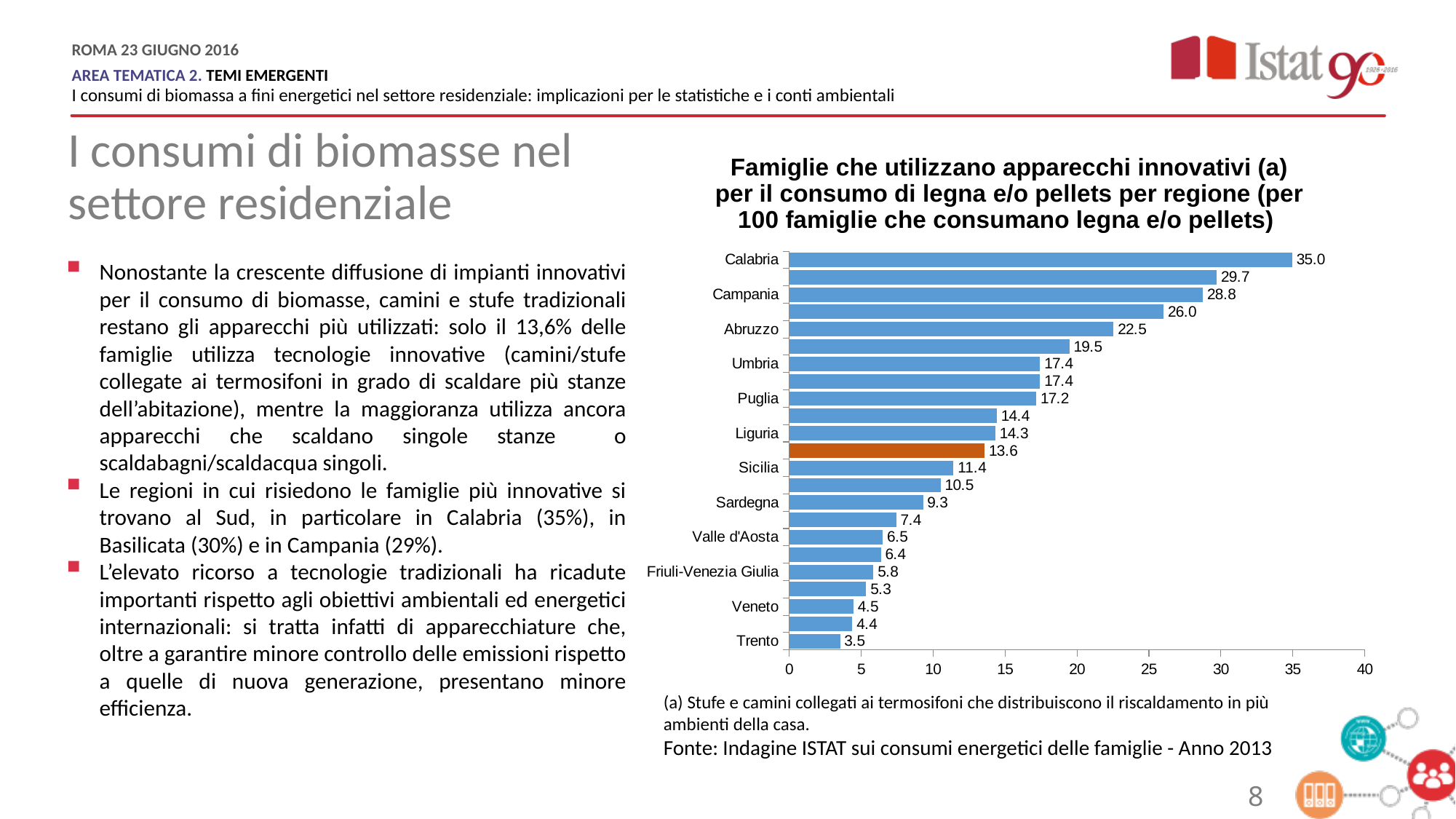
What kind of chart is shown on the slide? Bar chart What value is shown for Trento? 3.5 Is the value for Liguria greater or less than 15? less What value is shown for Sicilia? 11.4 What value is shown on the single orange bar? 13.6 How many bars are plotted in the chart? 23 Which has a larger value, Abruzzo or Puglia? Abruzzo Which labelled region has the highest value? Calabria What is the difference between the values for Calabria and Campania? 6.2 Which labelled region has the lowest value? Trento What value is shown for Calabria? 35.0 What value is shown for Campania? 28.8